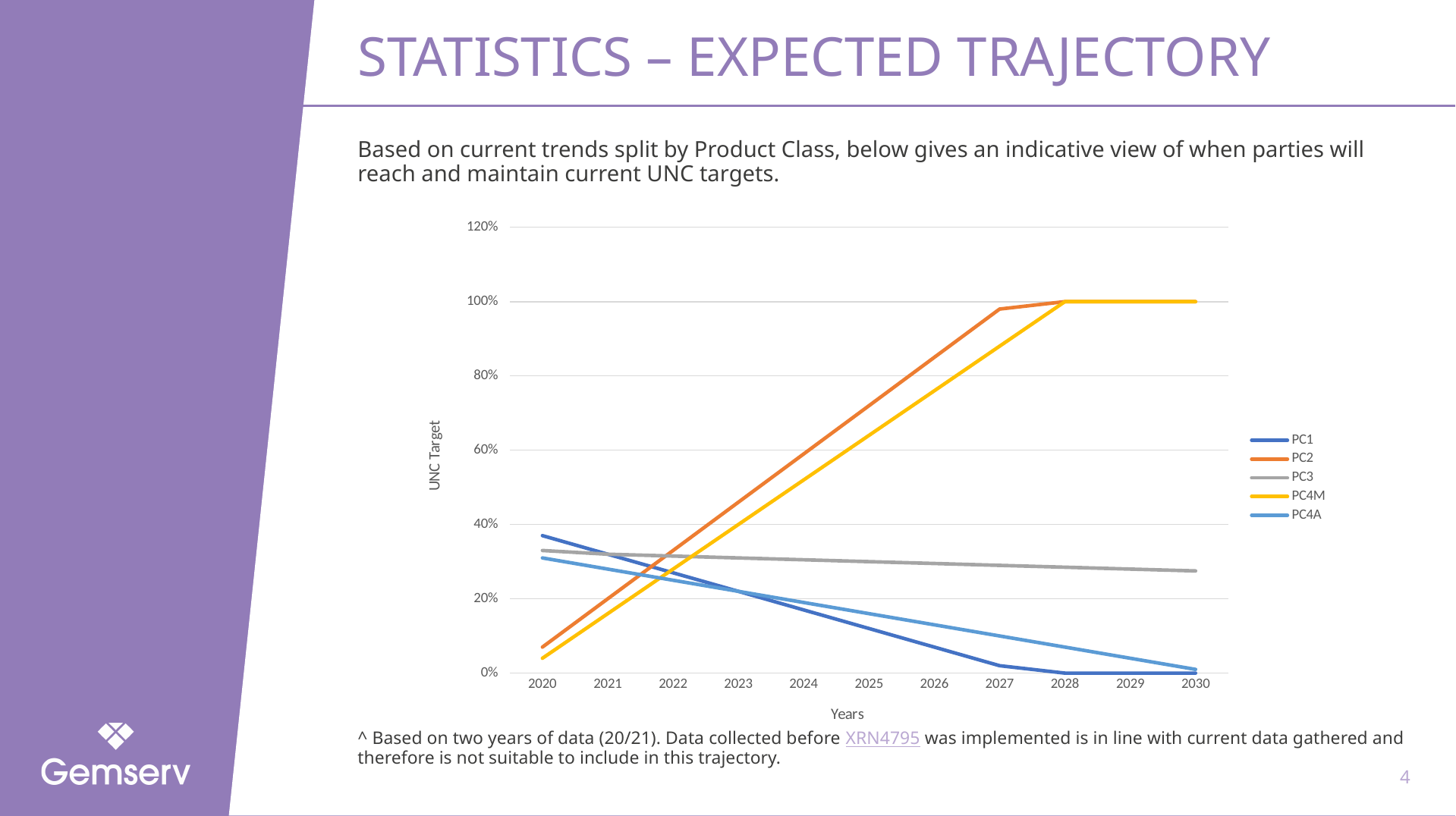
Does the PC2 line rise or fall from 2020 to 2027? rise Is the value for PC4A in 2027 greater or less than 20%? less What kind of chart is shown on the slide? line chart Is the value for PC3 in 2020 greater or less than 40%? less How many series does the legend list? 5 How many years are shown along the x axis? 11 Does the PC3 line rise or fall from 2020 to 2030? fall What is the title of the vertical axis? UNC Target Which series has the lowest value in 2024? PC1 Is the value for PC2 in 2025 greater or less than 60%? greater In 2026, which is higher, PC2 or PC3? PC2 What is the value for PC4M in 2029? 100%